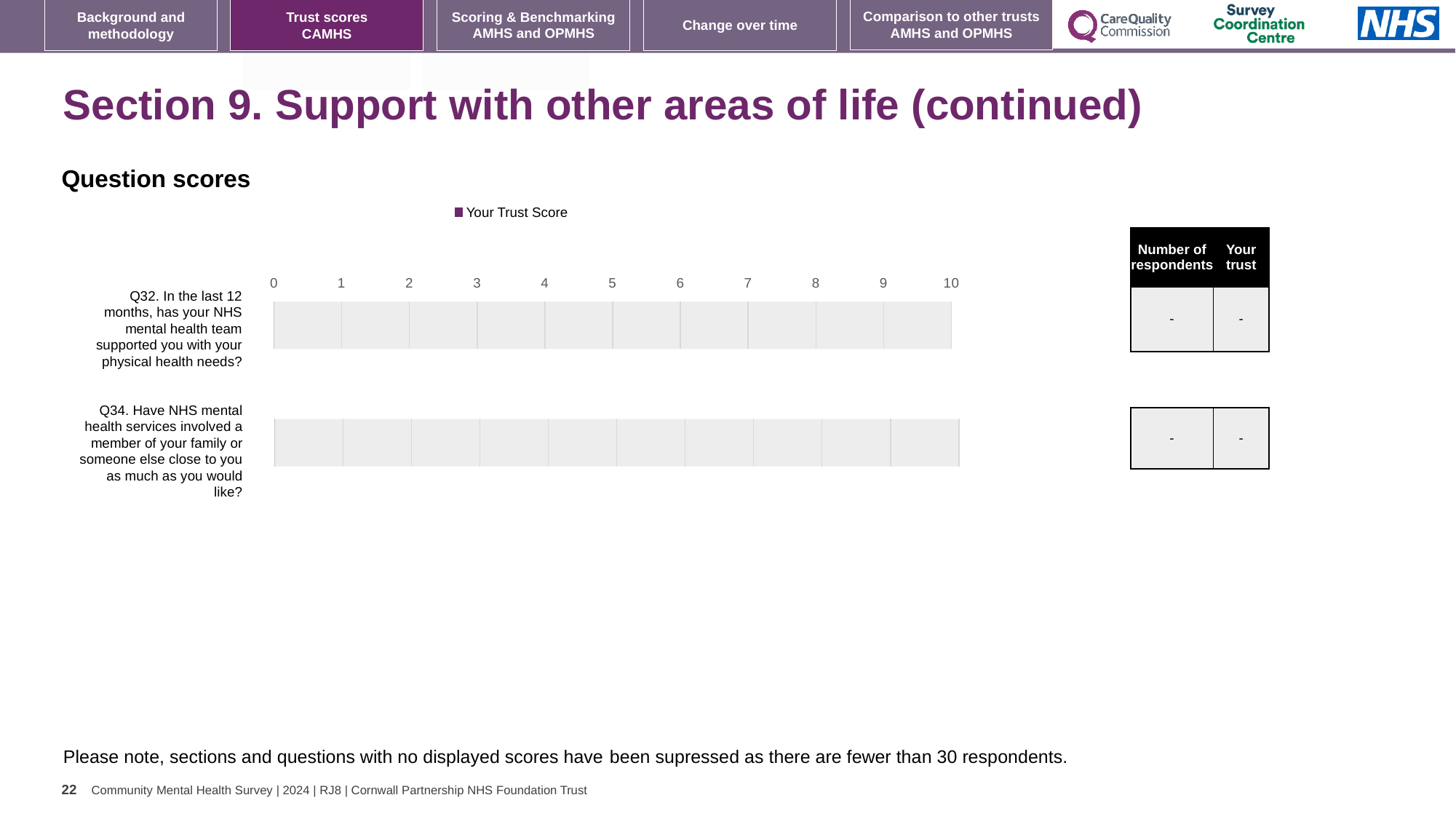
How many questions (categories) are listed on the chart's vertical axis? 2 What is the highest value shown on the chart's horizontal axis? 10 What is the name of the series shown in the chart legend? Your Trust Score How many series does the chart legend list? 1 What is shown in the "Your trust" column for Q34? - What is shown in the "Number of respondents" column for Q32? - What kind of chart is shown under "Question scores"? Bar chart